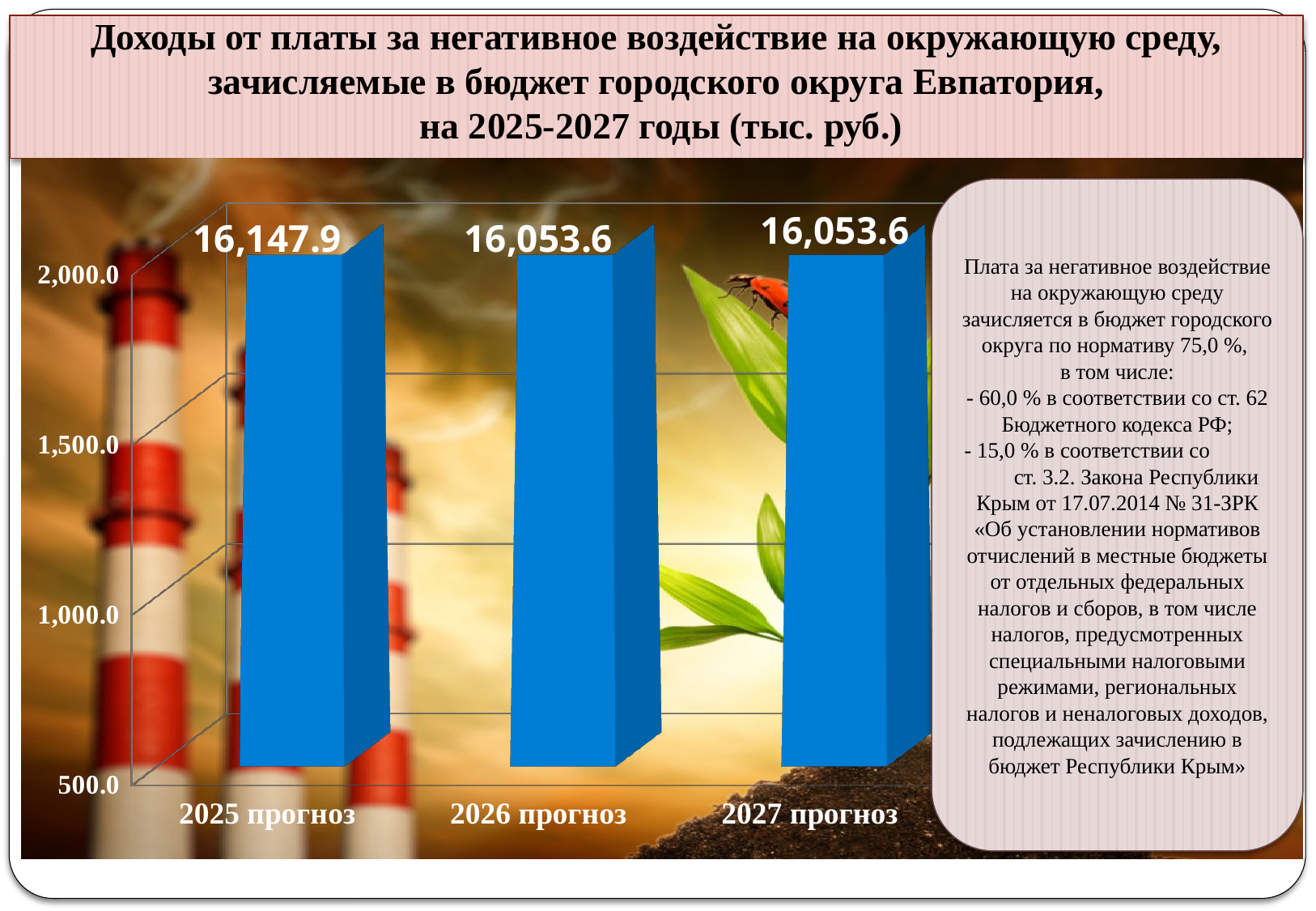
How do the values change from 2025 прогноз to 2027 прогноз? They fall from 2025 to 2026, then stay the same in 2027 What is the value for 2025 прогноз? 16,147.9 What is the value for 2027 прогноз? 16,053.6 Which is larger, the value for 2025 прогноз or 2027 прогноз? 2025 прогноз In what units are the values in the chart expressed, according to the title? тыс. руб. What is the value for 2026 прогноз? 16,053.6 What kind of chart is shown on the slide? Bar chart Which is larger, the value for 2026 прогноз or 2027 прогноз? They are equal What is the difference between the values for 2025 прогноз and 2026 прогноз? 94.3 How many bars are shown in the chart? 3 What colour are the bars in the chart? Blue Which year has the highest value? 2025 прогноз